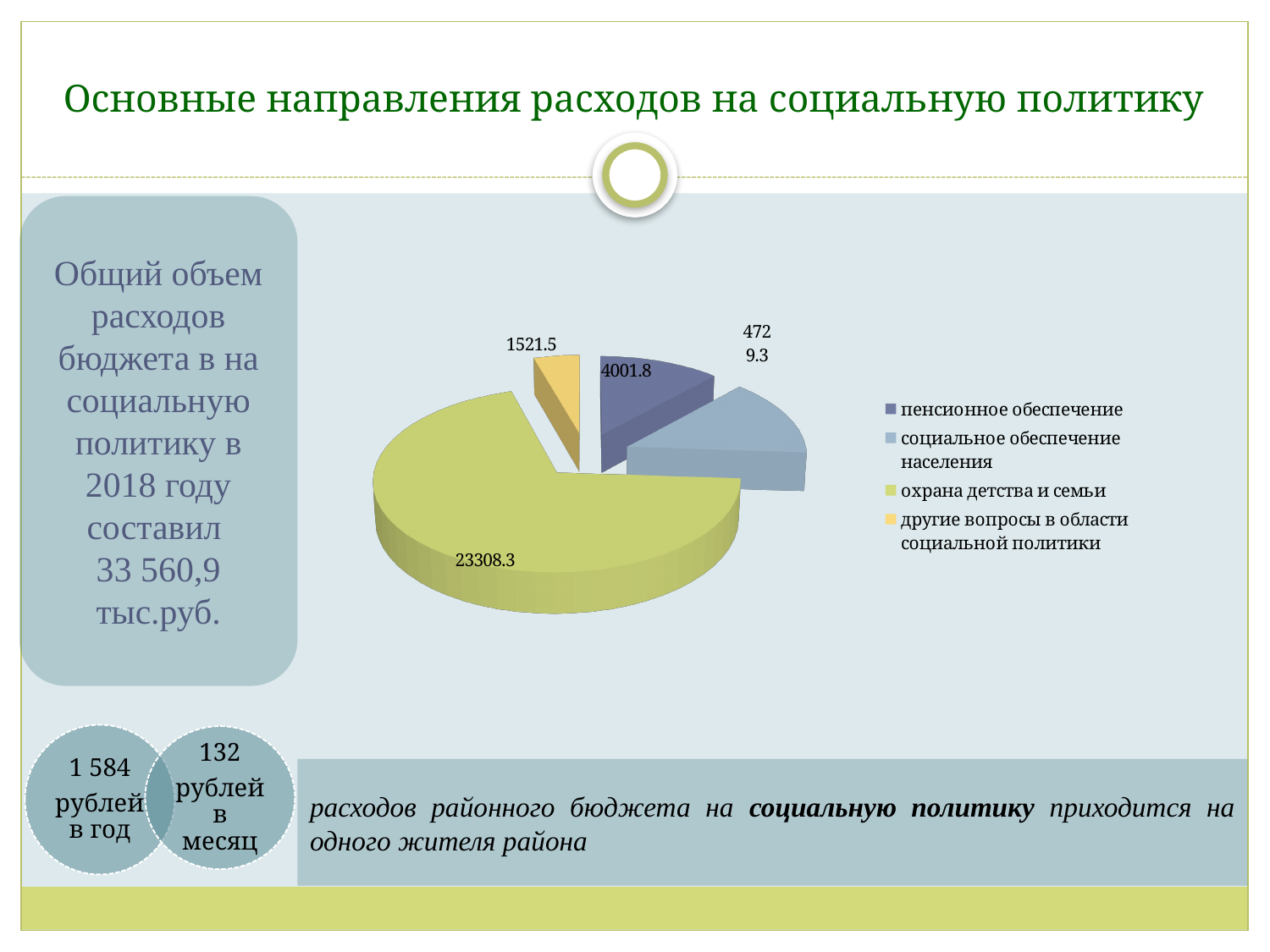
Which category has the smallest slice of the pie? другие вопросы в области социальной политики What kind of chart is shown on the slide? pie chart How many slices does the pie chart have? 4 Which is larger: пенсионное обеспечение or другие вопросы в области социальной политики? пенсионное обеспечение What is the value shown for пенсионное обеспечение? 4001.8 What is the difference between the values for охрана детства и семьи and пенсионное обеспечение? 19306.5 What colour is the slice for охрана детства и семьи? green How many entries does the legend of the pie chart list? 4 What is the difference between the values for пенсионное обеспечение and другие вопросы в области социальной политики? 2480.3 What is the value shown for другие вопросы в области социальной политики? 1521.5 Which category has the largest slice of the pie? охрана детства и семьи What is the value shown for охрана детства и семьи? 23308.3